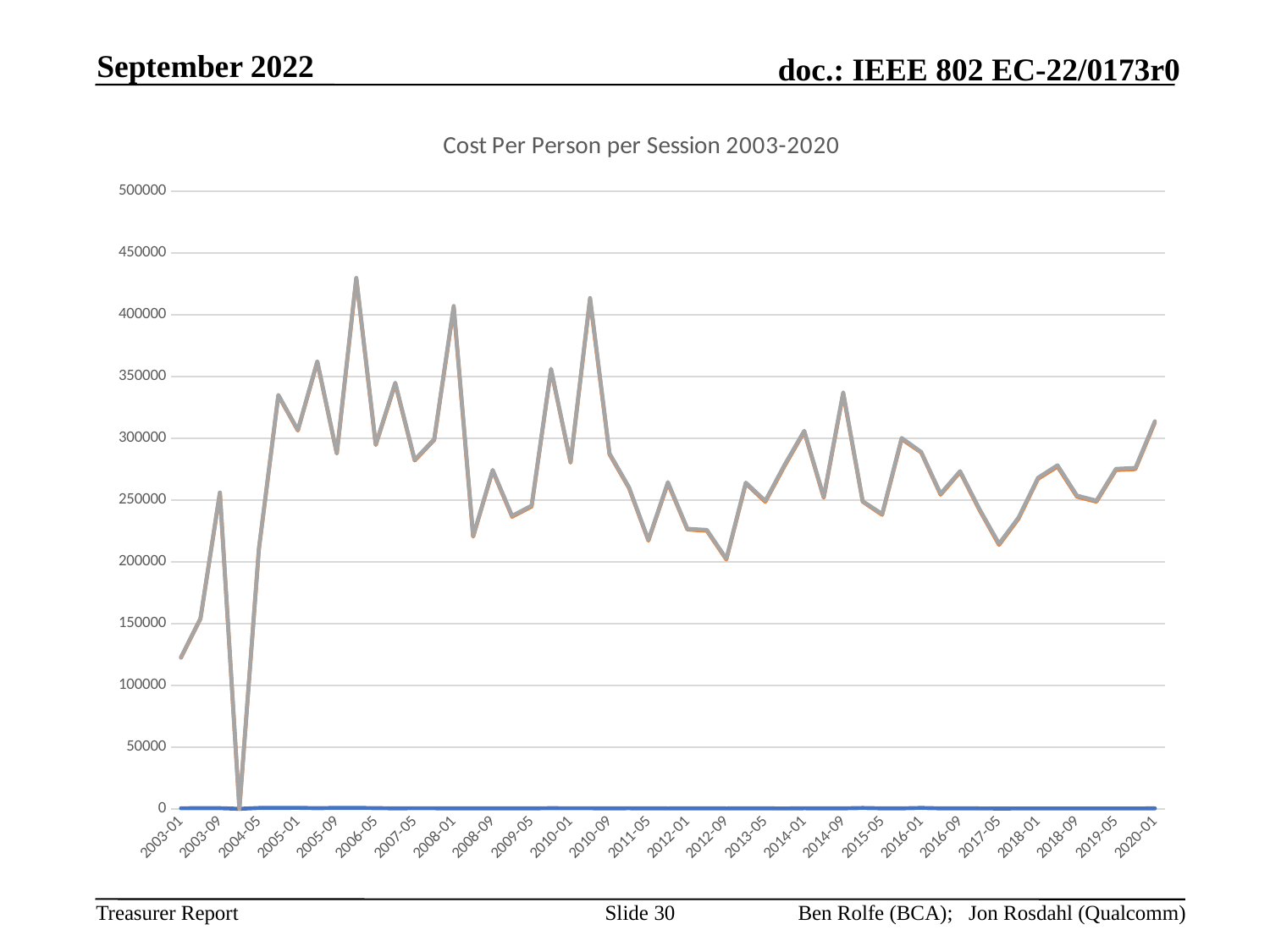
What is the lowest value reached by the line? 0 Is the value for 2003-01 greater or less than 150000? less Which is larger, the value for 2003-01 or the value for 2020-01? 2020-01 Is the value for 2017-05 greater or less than 250000? less What kind of chart is shown on the slide? line chart What is the title of the chart? Cost Per Person per Session 2003-2020 Is the value for 2014-09 greater or less than 300000? greater Does the line rise or fall between 2003-01 and 2003-09? rise What is the highest value shown on the vertical axis? 500000